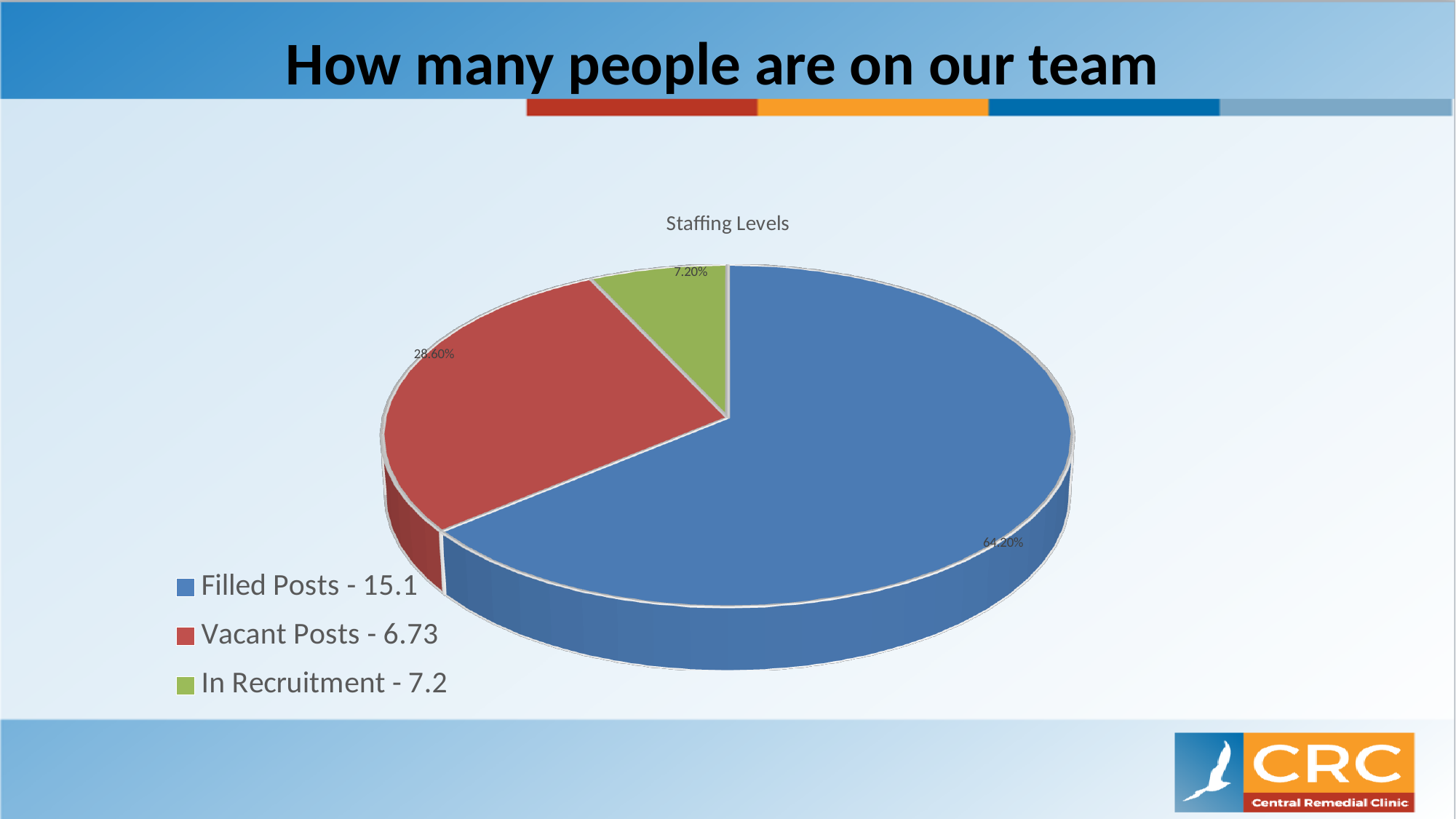
What percentage label is shown on the Filled Posts slice? 64.20% Which category has the largest slice of the pie? Filled Posts What percentage label is shown on the Vacant Posts slice? 28.60% How many entries does the legend list? 3 How many slices does the pie chart have? 3 What is the title of the chart? Staffing Levels What kind of chart is shown on the slide? pie chart What colour is the Vacant Posts slice? red Which slice is larger, Vacant Posts or In Recruitment? Vacant Posts Which category has the smallest slice of the pie? In Recruitment What percentage label is shown on the In Recruitment slice? 7.20% What is the difference between the percentage labels for Filled Posts and Vacant Posts? 35.60%